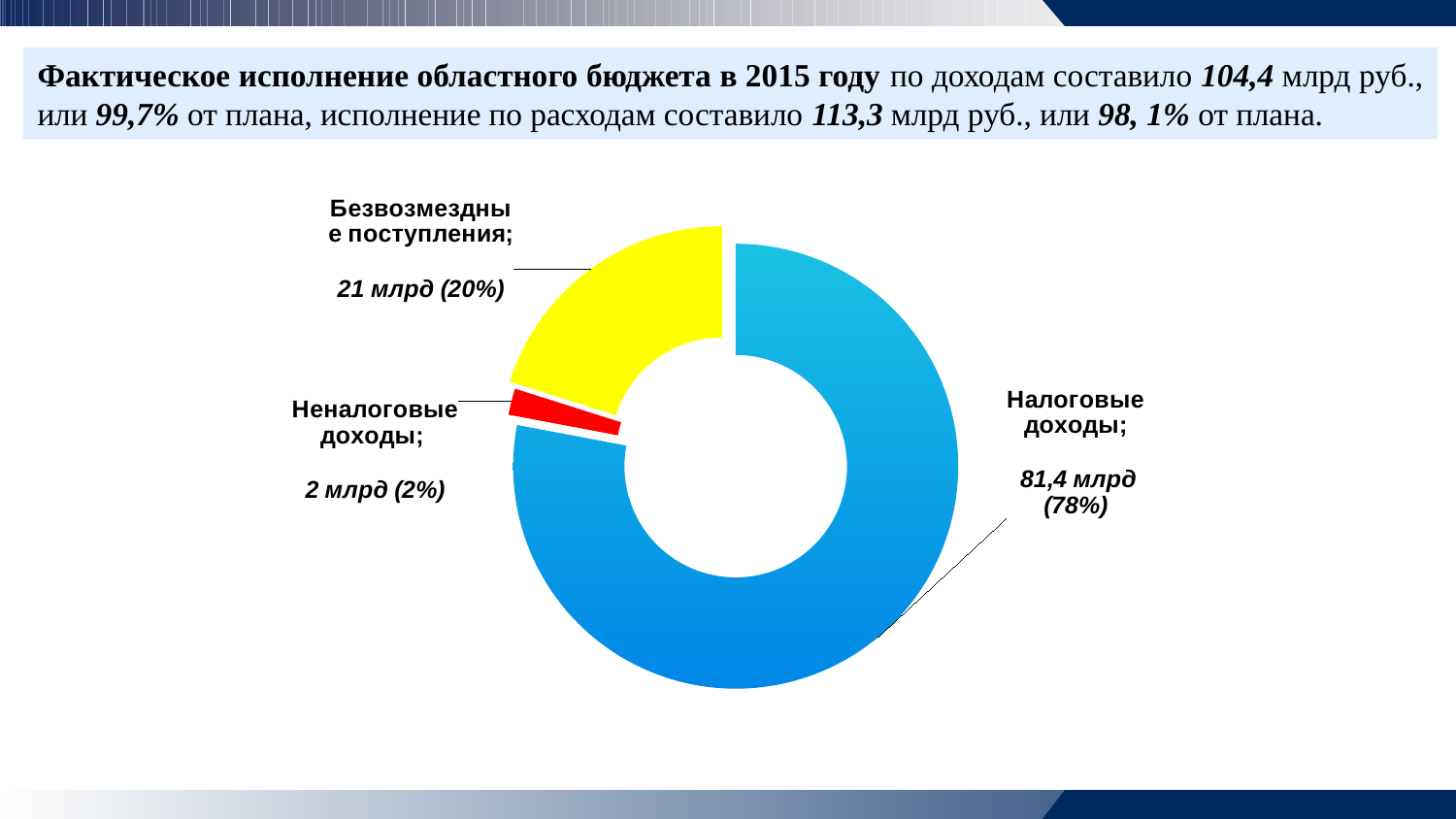
What is the difference between the values for Налоговые доходы and Безвозмездные поступления? 60,4 млрд What is the value for Безвозмездные поступления? 21 млрд How many categories does the chart show? 3 Which category has the smallest share of the chart? Неналоговые доходы What kind of chart is shown on the slide? Doughnut (pie) chart What colour is the slice for Неналоговые доходы? Red What is the value for Налоговые доходы? 81,4 млрд What is the value for Неналоговые доходы? 2 млрд Which is larger, Безвозмездные поступления or Неналоговые доходы? Безвозмездные поступления What share of the chart does Налоговые доходы represent? 78% What share of the chart does Безвозмездные поступления represent? 20% Which category has the largest share of the chart? Налоговые доходы